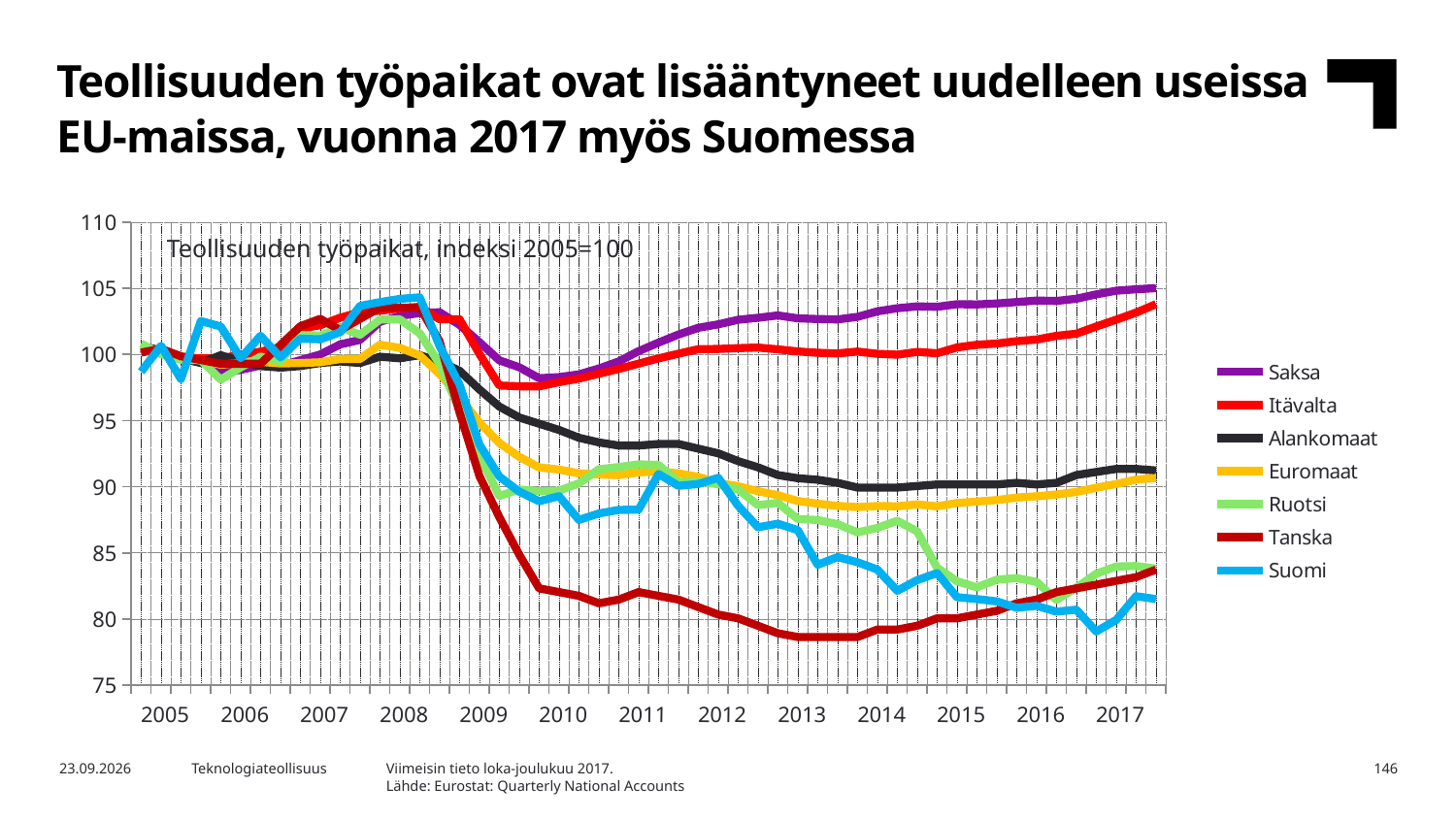
Does the value for Tanska rise or fall between 2008 and 2013? fall Is the value for Suomi in 2016 greater or less than 85? less Which series is listed last in the legend? Suomi How many years are labelled on the x axis? 13 How many series does the legend list? 7 What kind of chart is shown on the slide? line chart Which series has the highest value at the end of 2017? Saksa Which is larger in 2013, the value for Saksa or the value for Tanska? Saksa What is the title printed inside the chart area? Teollisuuden työpaikat, indeksi 2005=100 Is the value for Tanska in 2013 greater or less than 80? less Which series has the lowest value at the end of 2017? Suomi Is the value for Itävalta at the end of 2017 greater or less than 100? greater